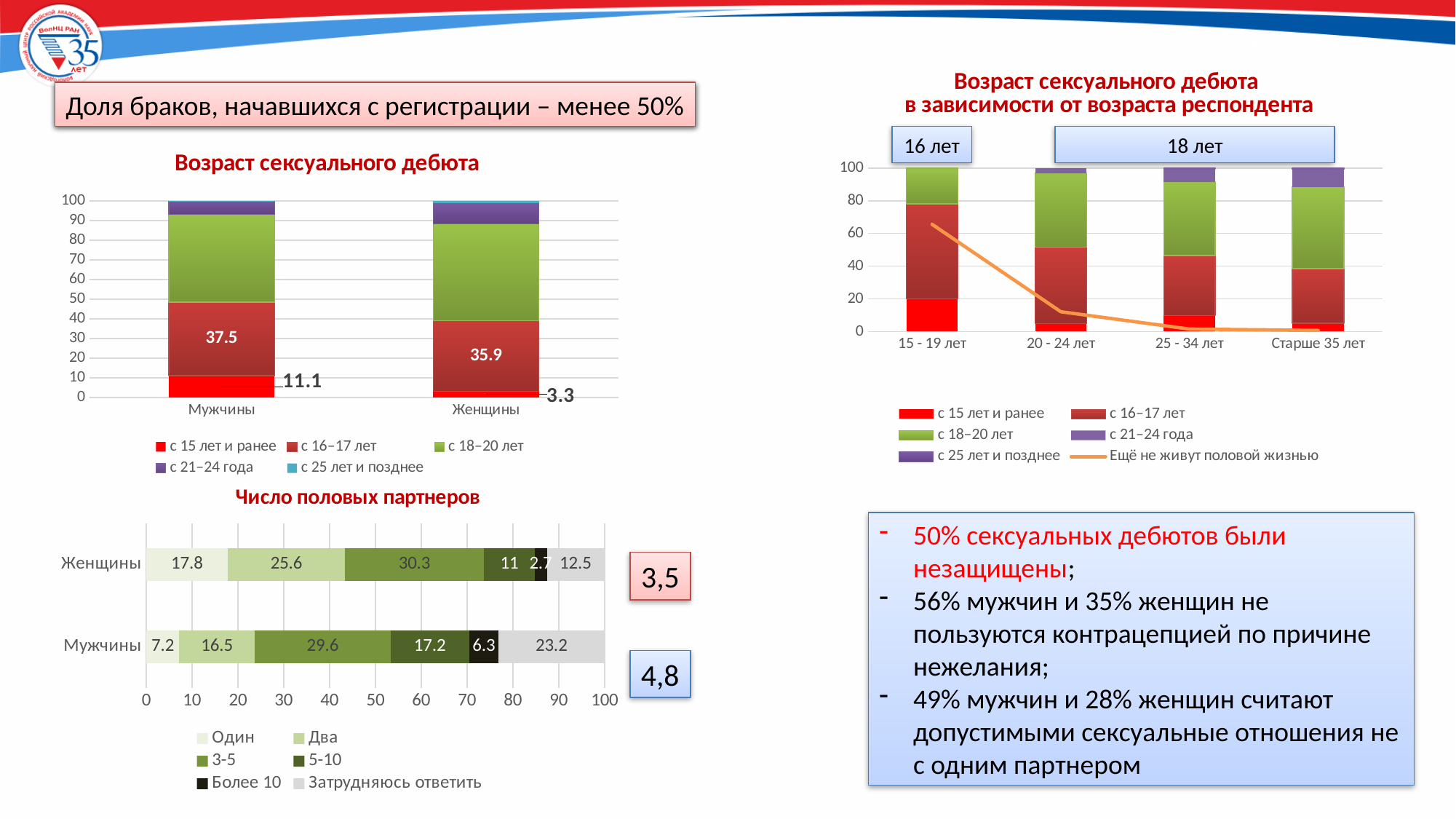
In the chart 'Число половых партнеров', what is the value of 'Затрудняюсь ответить' for Мужчины? 23.2 In the chart 'Возраст сексуального дебюта', what is the difference between the 'с 16–17 лет' values for Мужчины and Женщины? 1.6 In the chart 'Возраст сексуального дебюта в зависимости от возраста респондента', does the line 'Ещё не живут половой жизнью' rise or fall from '15 - 19 лет' to 'Старше 35 лет'? Fall In the chart 'Возраст сексуального дебюта', what is the value of the 'с 16–17 лет' segment for Женщины? 35.9 What kind of chart is 'Число половых партнеров'? Stacked horizontal bar chart In the chart 'Число половых партнеров', which category has the larger value for 'Один': Женщины or Мужчины? Женщины In the chart 'Возраст сексуального дебюта', what is the value of the 'с 16–17 лет' segment for Мужчины? 37.5 How many series does the legend of the chart 'Возраст сексуального дебюта' list? 5 In the chart 'Число половых партнеров', what is the value of 'Два' for Женщины? 25.6 In the chart 'Число половых партнеров', what is the difference between the '5-10' values for Мужчины and Женщины? 6.2 How many series does the legend of the chart 'Число половых партнеров' list? 6 In the chart 'Возраст сексуального дебюта в зависимости от возраста респондента', how many age categories are shown on the x axis? 4